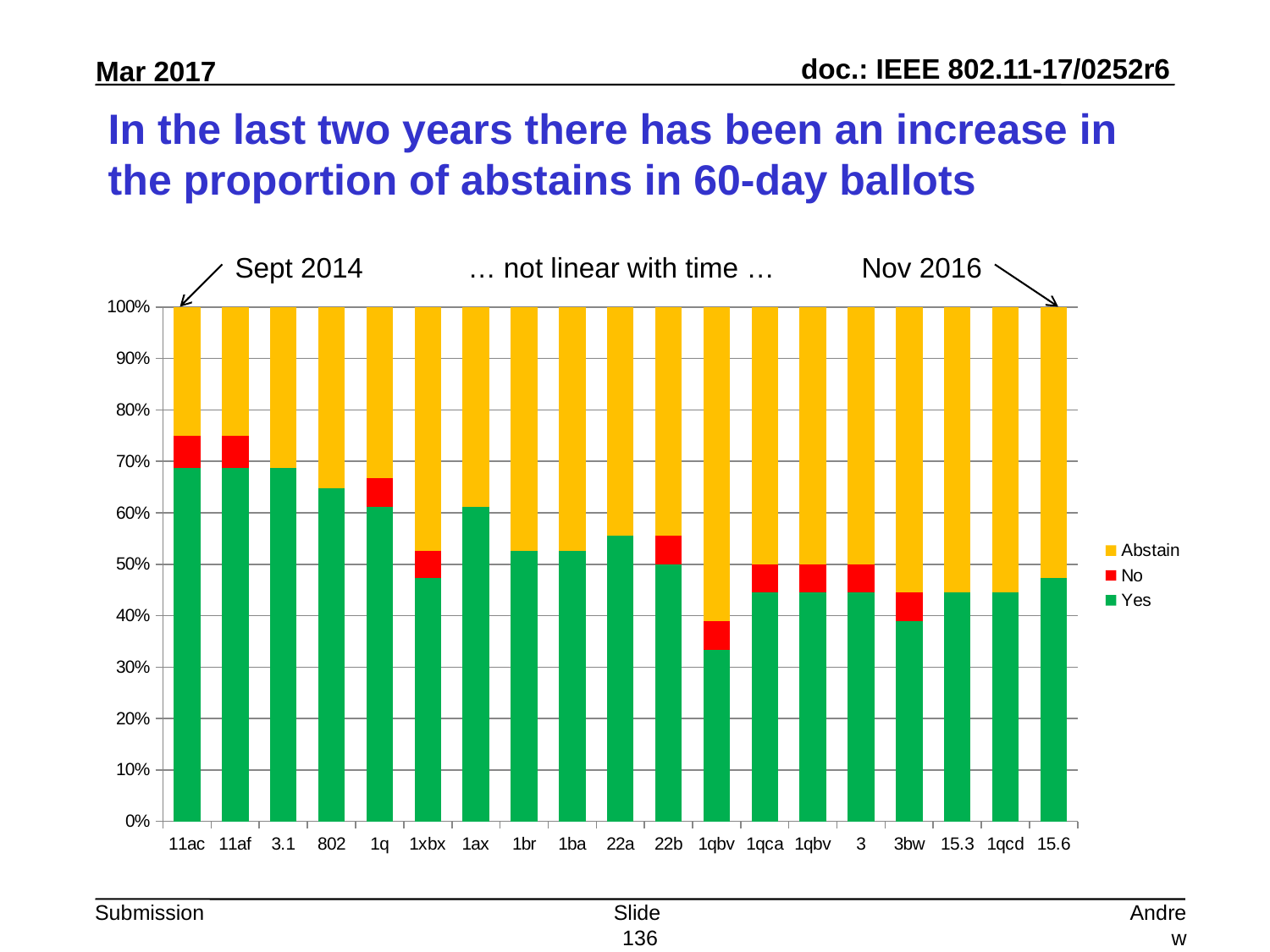
Is the Abstain share for 11ac greater or less than 30%? less Which colour represents Abstain in the legend? Yellow How many ballot categories are shown along the x axis? 19 What kind of chart is shown on the slide? Stacked bar chart How many series does the legend list? 3 Which has the larger Yes share, 11ac or 15.6? 11ac Does the Yes share generally rise or fall moving from left to right along the x axis? fall Is the Yes share for 802 greater or less than 60%? greater Which has the larger Yes share, 22a or 3bw? 22a Is the Yes share for 15.6 greater or less than 50%? less